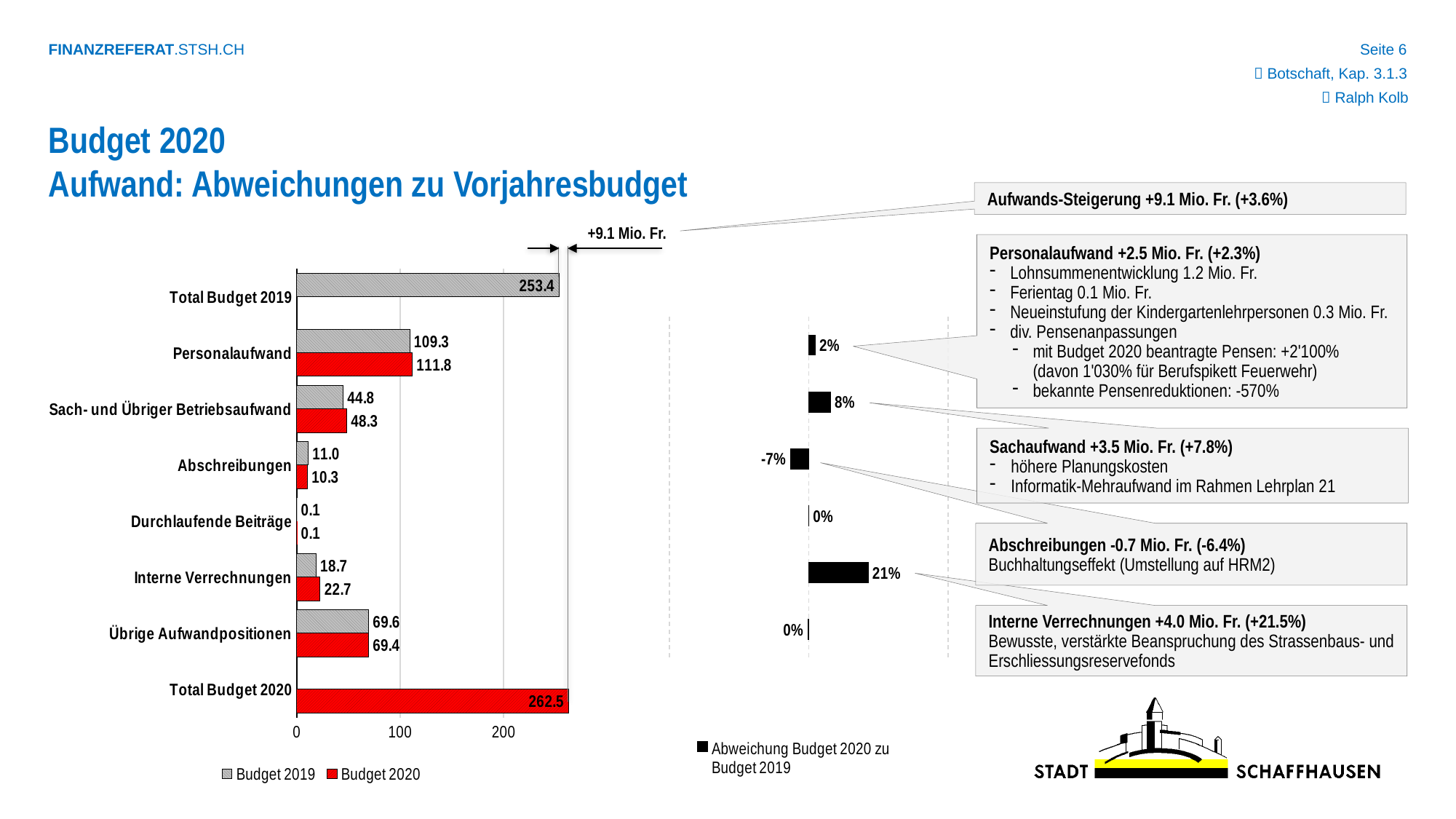
What kind of chart is the left chart? bar chart In the right chart (Abweichung Budget 2020 zu Budget 2019), what is the highest percentage value shown? 21% In the left chart (Budget 2019 vs Budget 2020), what is the Budget 2020 value for Personalaufwand? 111.8 In the left chart, what is the difference between the Budget 2020 and Budget 2019 values for Interne Verrechnungen? 4.0 In the left chart, what is the Budget 2020 value for Interne Verrechnungen? 22.7 In the left chart, what is the difference between Total Budget 2020 and Total Budget 2019? 9.1 In the left chart, is the value for Total Budget 2020 greater or less than 200? greater In the left chart, which is larger for Abschreibungen: the Budget 2019 value or the Budget 2020 value? Budget 2019 In the left chart, excluding the two total bars, which category has the highest Budget 2020 value? Personalaufwand How many series does the legend of the left chart list? 2 In the left chart, what is the Budget 2019 value for Sach- und Übriger Betriebsaufwand? 44.8 What is the legend entry of the right chart? Abweichung Budget 2020 zu Budget 2019